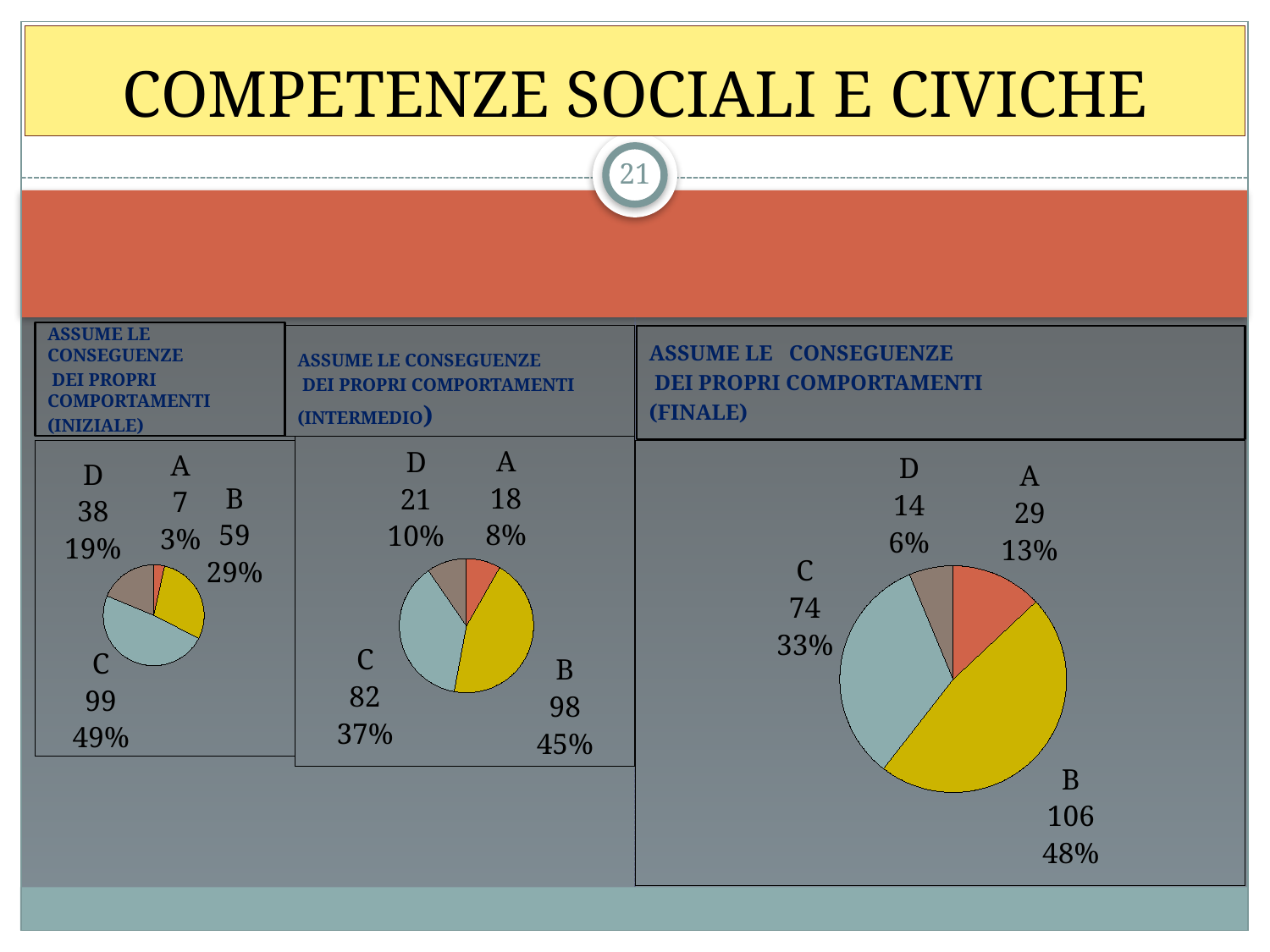
In the INIZIALE pie chart, what is the count for category C? 99 In the FINALE pie chart, which is larger, the count for A or the count for D? A In the INIZIALE pie chart, which category has the largest share? C In the INTERMEDIO pie chart, what is the difference between the counts for B and C? 16 In the INIZIALE pie chart, what percentage share does category A have? 3% How many pie charts are shown on the slide? 3 How many categories does the FINALE pie chart show? 4 In the INTERMEDIO pie chart, which category has the smallest share? A In the FINALE pie chart, what percentage share does category B have? 48% What type of chart is used in the INTERMEDIO panel? Pie chart In the INTERMEDIO pie chart, what is the count for category B? 98 In the FINALE pie chart, what is the count for category D? 14